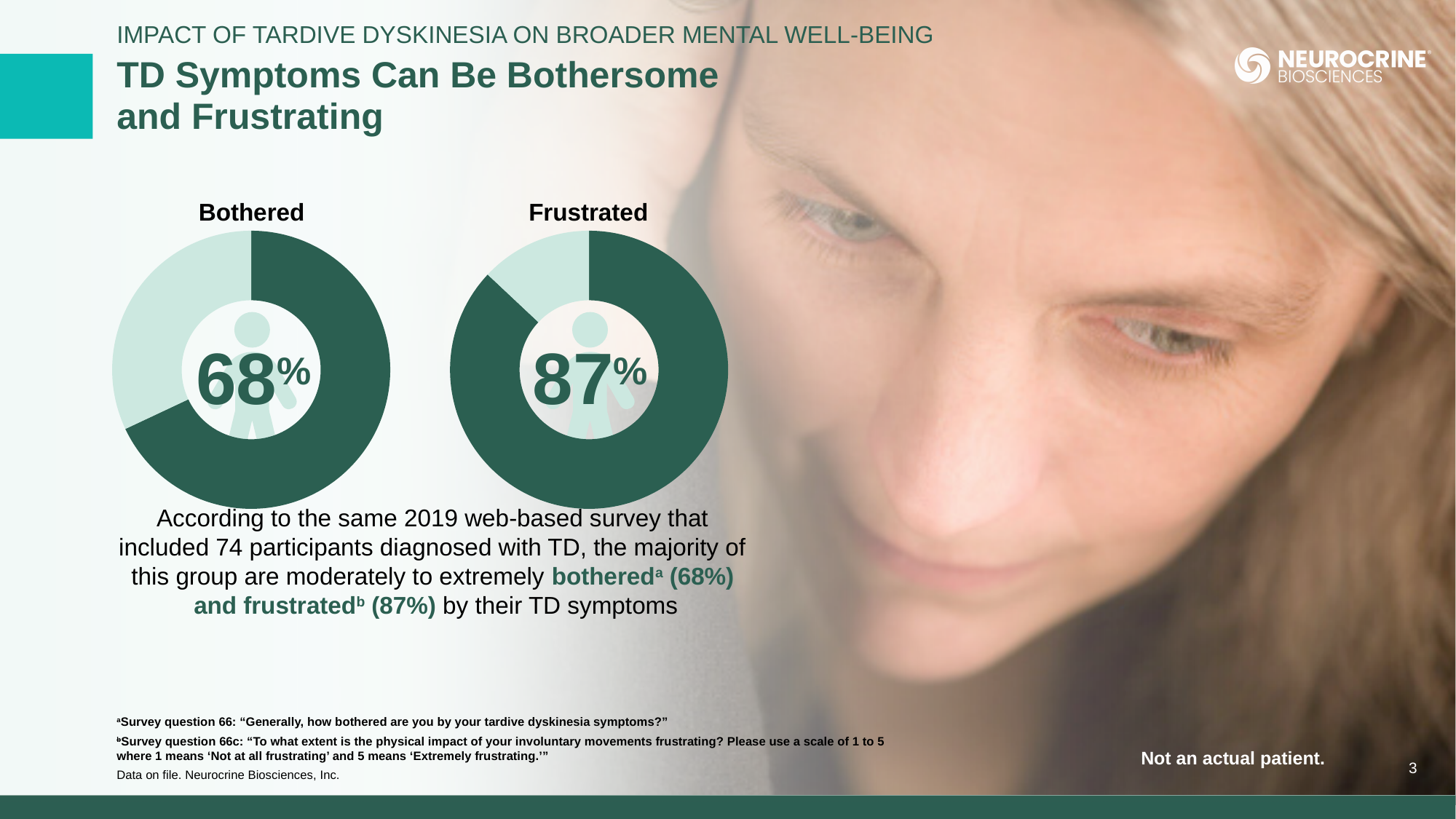
What percentage is shown in the 'Bothered' donut chart? 68% What percentage is shown in the 'Frustrated' donut chart? 87% In the 'Frustrated' donut chart, what share of the ring is shown in the light green colour? 13% How many donut charts are shown on the slide? 2 Which of the two donut charts shows the lower percentage? Bothered Which of the two donut charts shows the higher percentage, 'Bothered' or 'Frustrated'? Frustrated What type of chart is used to show the 'Bothered' and 'Frustrated' percentages? Donut (pie) chart In the 'Bothered' donut chart, what share of the ring is shown in the dark green colour? 68% What is the label above the left donut chart? Bothered What is the difference in percentage points between the 'Frustrated' value and the 'Bothered' value? 19 Is the value in the 'Bothered' donut chart greater or less than 50%? greater What is the label above the right donut chart? Frustrated